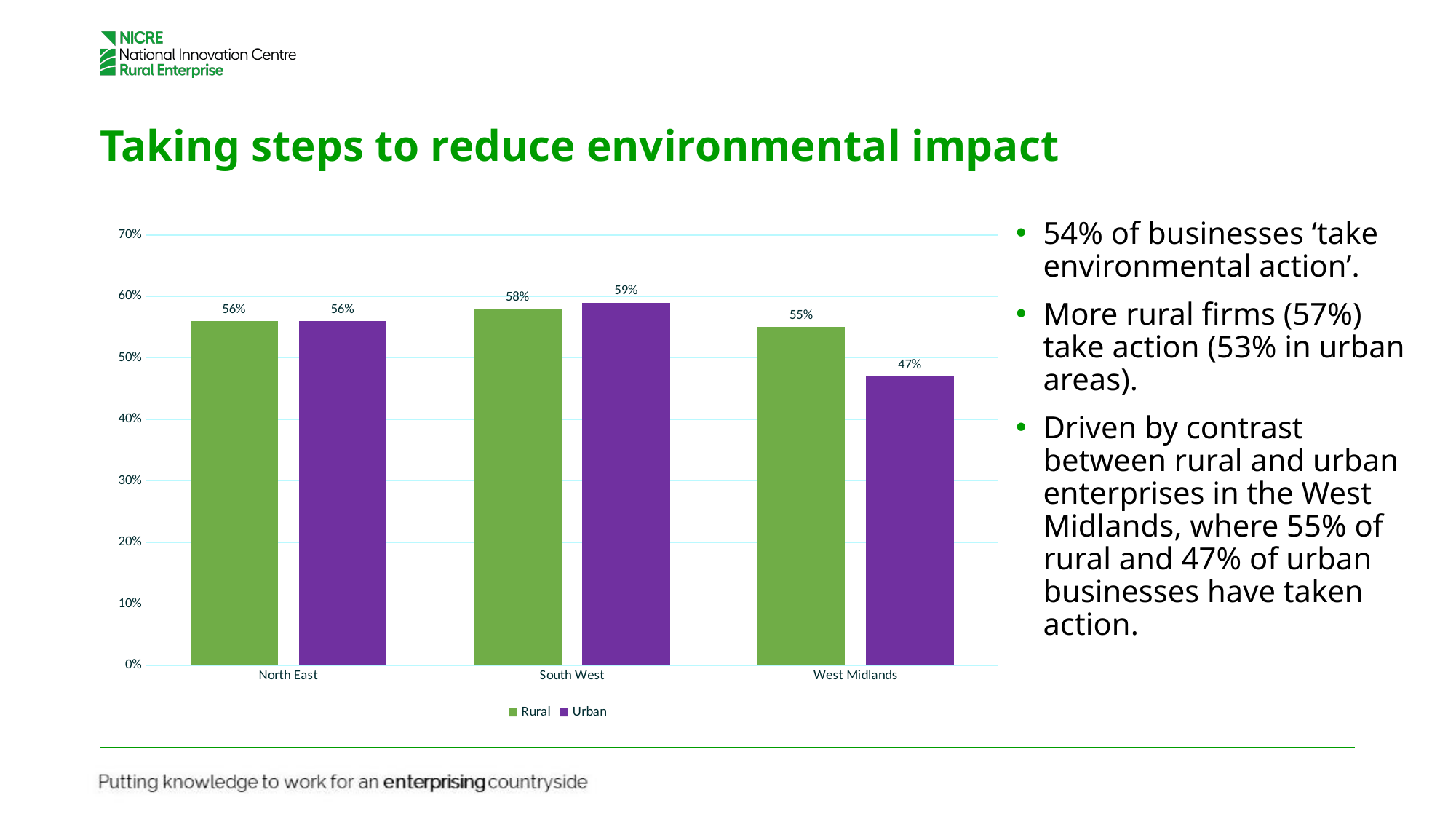
Which colour represents the Urban series in the chart? Purple Which region has the highest Rural value? South West How many series does the legend list? 2 Which region has the lowest Urban value? West Midlands Is the Urban value for West Midlands greater or less than 50%? less How many regions are shown on the x axis? 3 What is the difference between the Rural and Urban values for West Midlands? 8% What is the Urban value for West Midlands? 47% What is the Rural value for South West? 58% What kind of chart is shown on the slide? Bar chart Which is larger for West Midlands, the Rural value or the Urban value? Rural What is the Urban value for North East? 56%